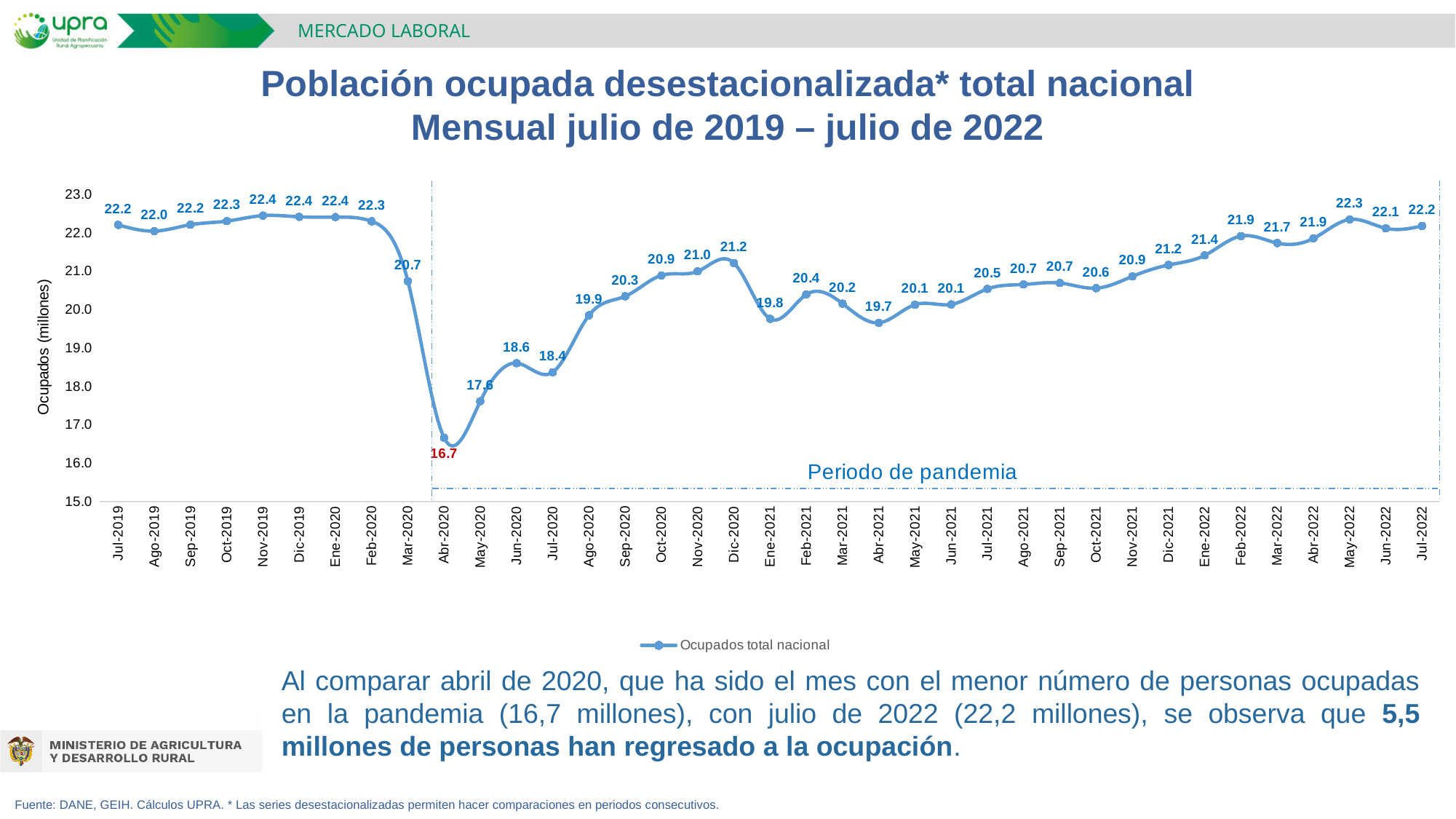
How many series does the legend list? 1 Which month has the lowest value? Abr-2020 What type of chart is shown on the slide? line chart Which is larger, the value for Jun-2020 or the value for Jul-2020? Jun-2020 What is the difference between the values for Jul-2022 and Abr-2020? 5.5 What is the value for Dic-2020? 21.2 What is the difference between the values for Feb-2020 and Mar-2020? 1.6 How many monthly data points are plotted on the chart? 37 What is the value for Mar-2020? 20.7 What is the value for Jul-2022? 22.2 Do the values rise or fall from Abr-2020 to Dic-2020? rise What is the value for Abr-2020? 16.7